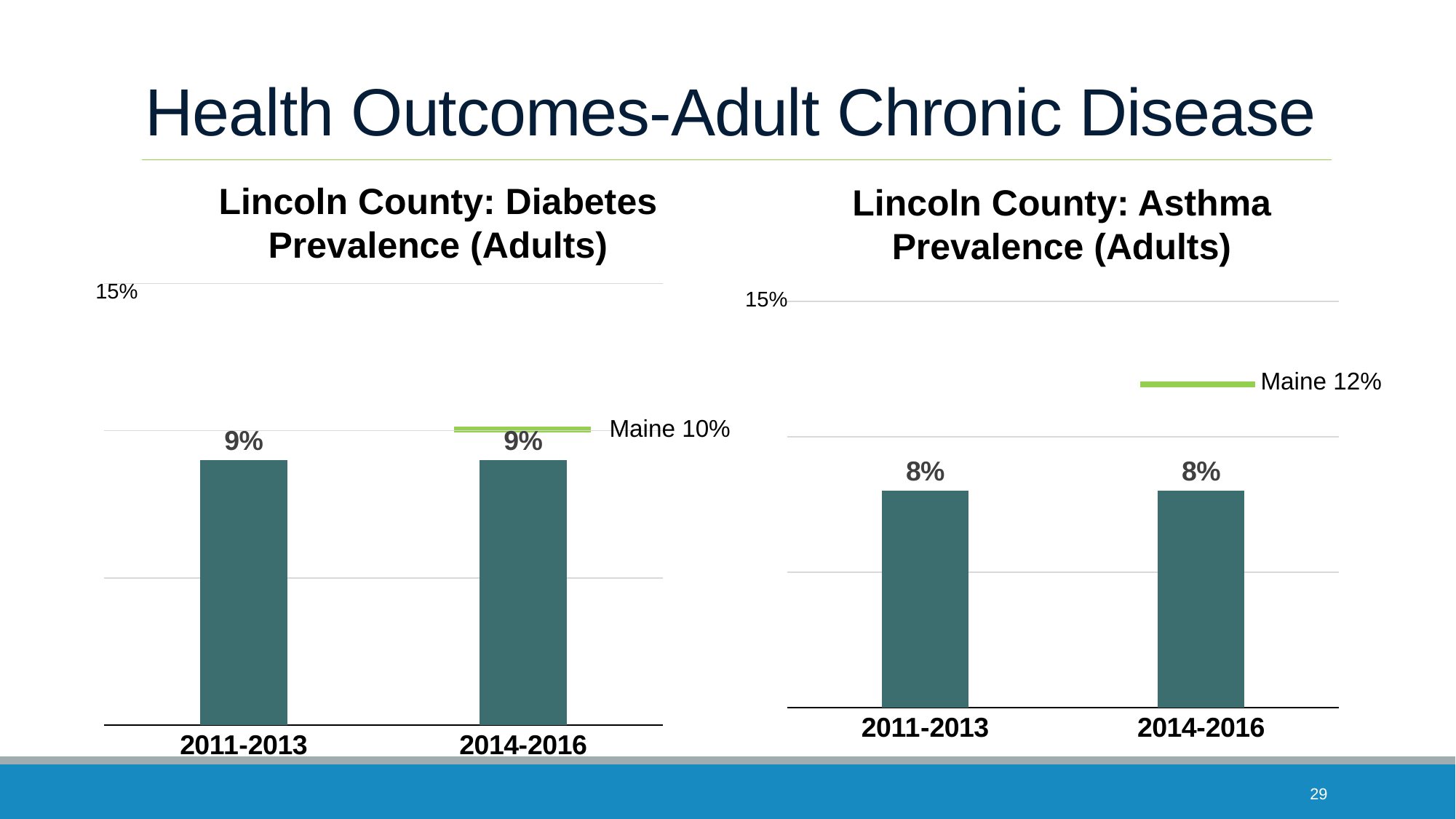
What kind of chart is the Lincoln County: Asthma Prevalence (Adults) chart? Bar chart In the Lincoln County: Diabetes Prevalence (Adults) chart, what is the value for 2014-2016? 9% In the Lincoln County: Diabetes Prevalence (Adults) chart, what is the difference between the Maine value and the 2014-2016 Lincoln County value? 1% In the Lincoln County: Asthma Prevalence (Adults) chart, what is the difference between the Maine value and the 2014-2016 Lincoln County value? 4% In the Lincoln County: Diabetes Prevalence (Adults) chart, what is the Maine reference value shown? Maine 10% In the Lincoln County: Asthma Prevalence (Adults) chart, what is the Maine reference value shown? Maine 12% How many bars are plotted in the Lincoln County: Diabetes Prevalence (Adults) chart? 2 In the Lincoln County: Asthma Prevalence (Adults) chart, what is the value for 2014-2016? 8% In the Lincoln County: Asthma Prevalence (Adults) chart, do the values rise, fall or stay the same from 2011-2013 to 2014-2016? Stay the same In the Lincoln County: Diabetes Prevalence (Adults) chart, is the value for 2011-2013 greater or less than 15%? less In the Lincoln County: Diabetes Prevalence (Adults) chart, what is the value for 2011-2013? 9% In the Lincoln County: Asthma Prevalence (Adults) chart, what is the value for 2011-2013? 8%